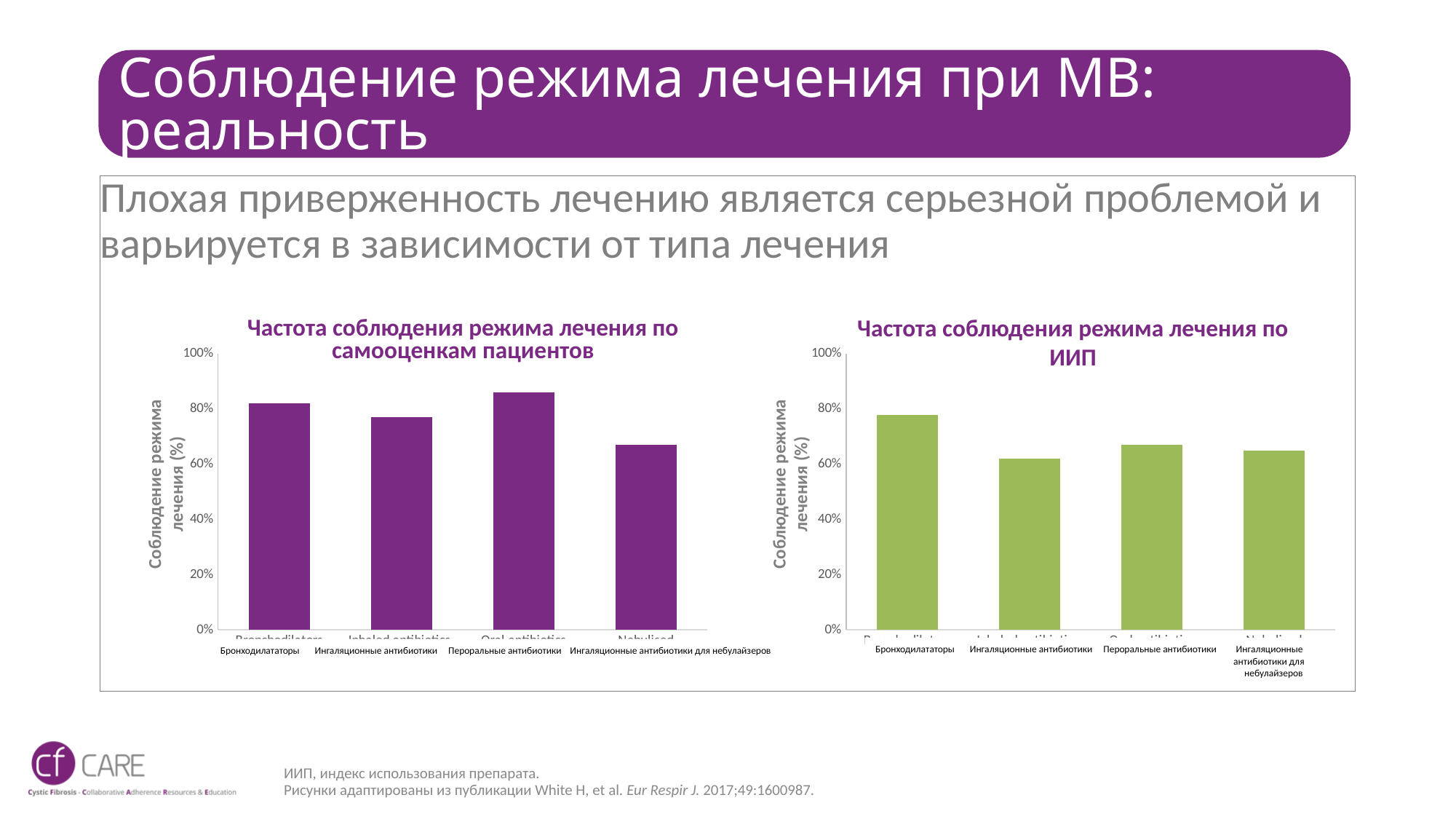
How many categories are shown in the left chart, 'Частота соблюдения режима лечения по самооценкам пациентов'? 4 In the right chart, 'Частота соблюдения режима лечения по ИИП', which is larger: the value for Бронходилататоры or the value for Ингаляционные антибиотики? Бронходилататоры How many categories are shown in the right chart, 'Частота соблюдения режима лечения по ИИП'? 4 In the right chart, 'Частота соблюдения режима лечения по ИИП', which category has the highest value? Бронходилататоры What colour are the bars in the right chart, 'Частота соблюдения режима лечения по ИИП'? Green In the left chart, 'Частота соблюдения режима лечения по самооценкам пациентов', which category has the highest value? Пероральные антибиотики In the left chart, 'Частота соблюдения режима лечения по самооценкам пациентов', which category has the lowest value? Ингаляционные антибиотики для небулайзеров In the left chart, 'Частота соблюдения режима лечения по самооценкам пациентов', which is larger: the value for Бронходилататоры or the value for Ингаляционные антибиотики? Бронходилататоры What kind of chart is the left chart, 'Частота соблюдения режима лечения по самооценкам пациентов'? Bar chart In the right chart, 'Частота соблюдения режима лечения по ИИП', is the value for Ингаляционные антибиотики greater or less than 80%? less In the left chart, 'Частота соблюдения режима лечения по самооценкам пациентов', is the value for Ингаляционные антибиотики для небулайзеров greater or less than 80%? less